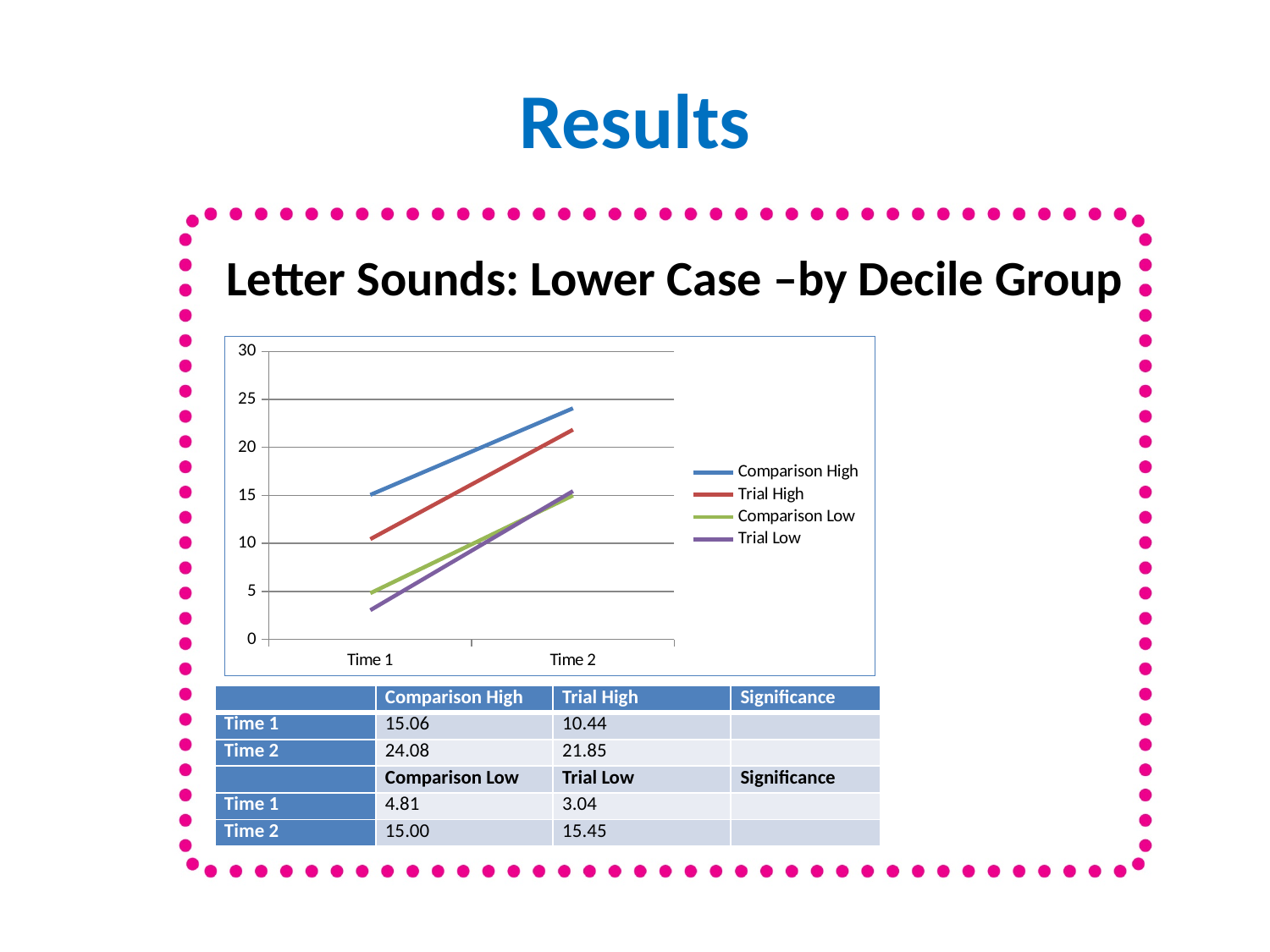
Do the values for Trial High rise or fall from Time 1 to Time 2? rise What kind of chart is shown on the slide? line chart How many series does the chart legend list? 4 What is the value for Trial Low at Time 1? 3.04 What is the value for Trial High at Time 2? 21.85 Which is larger at Time 2, Comparison Low or Trial Low? Trial Low Which series has the highest value at Time 2? Comparison High Is the value for Comparison High at Time 2 greater or less than 20? greater How many time points are shown on the x axis of the chart? 2 What is the value for Comparison High at Time 1? 15.06 Which series has the lowest value at Time 1? Trial Low What is the difference between Comparison High and Trial High at Time 1? 4.62